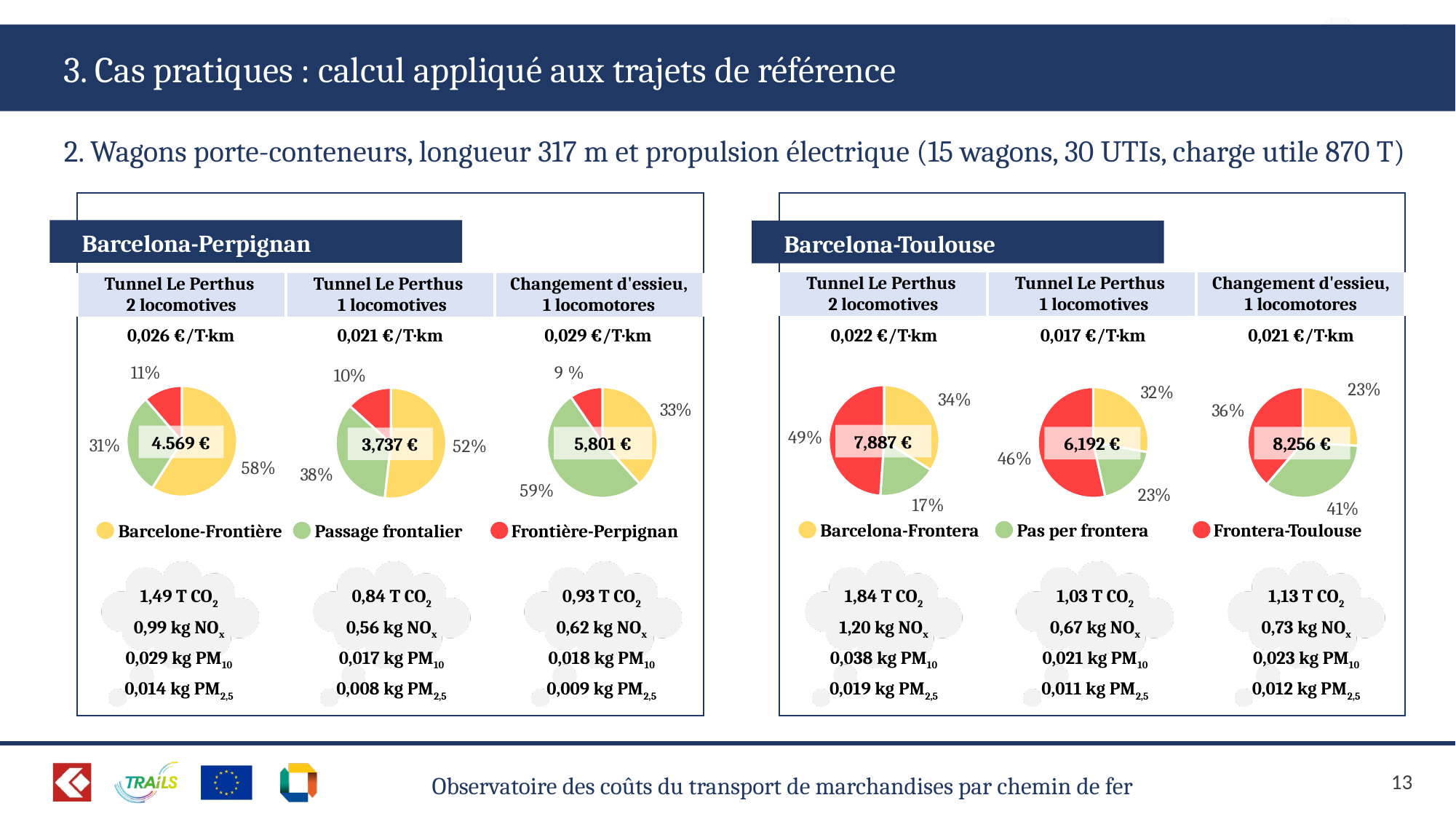
How many segments does each pie chart on the slide have? 3 In the Barcelona-Toulouse 'Tunnel Le Perthus 2 locomotives' pie chart, what share is Frontera-Toulouse? 49% In the Barcelona-Perpignan 'Tunnel Le Perthus 2 locomotives' pie chart, what share is Barcelone-Frontière? 58% How many entries does the legend under the Barcelona-Toulouse pie charts list? 3 In the Barcelona-Perpignan 'Tunnel Le Perthus 1 locomotives' pie chart, what share is Passage frontalier? 38% In the Barcelona-Perpignan 'Changement d'essieu, 1 locomotores' pie chart, which segment is the largest? Passage frontalier In the Barcelona-Toulouse 'Changement d'essieu, 1 locomotores' pie chart, what is the difference between the Pas per frontera share and the Barcelona-Frontera share? 18% In the Barcelona-Perpignan 'Tunnel Le Perthus 2 locomotives' pie chart, which is larger: Passage frontalier or Frontière-Perpignan? Passage frontalier In the Barcelona-Toulouse 'Changement d'essieu, 1 locomotores' pie chart, which segment is the largest? Pas per frontera What type of chart is used to show the cost breakdown for each scenario on the slide? Pie chart In the Barcelona-Perpignan 'Changement d'essieu, 1 locomotores' pie chart, which segment is the smallest? Frontière-Perpignan